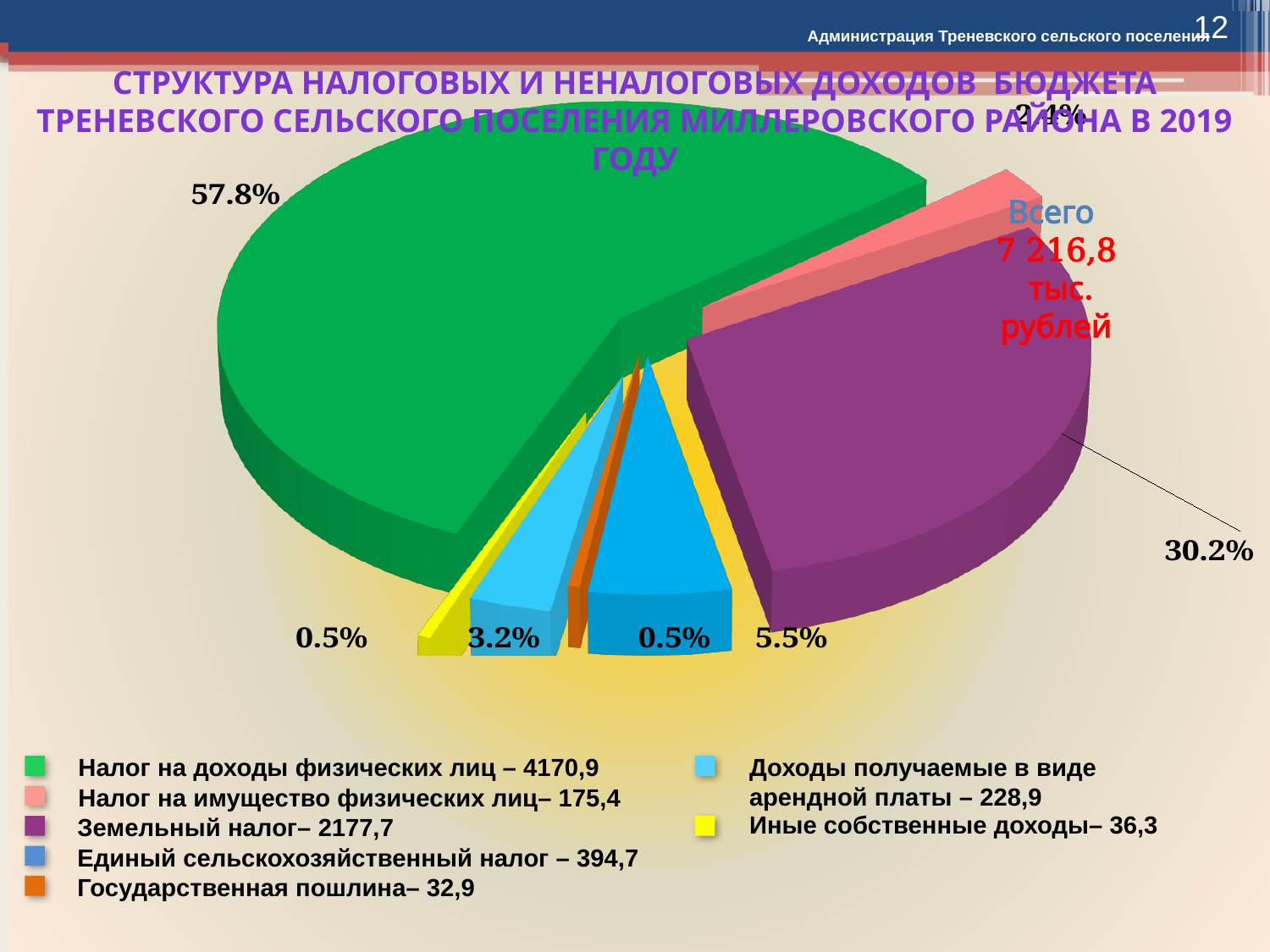
What value does the legend give for Земельный налог? 2177,7 What percentage share is shown for Доходы получаемые в виде арендной платы? 3.2% What value does the legend give for Государственная пошлина? 32,9 Which has the larger share: Земельный налог or Единый сельскохозяйственный налог? Земельный налог What total amount (Всего) is shown next to the pie chart? 7 216,8 тыс. рублей What is the difference in percentage points between the share of Налог на доходы физических лиц (57.8%) and Земельный налог (30.2%)? 27.6 Which category has the largest share of the pie? Налог на доходы физических лиц What colour is the slice for Налог на доходы физических лиц? green What percentage share does Единый сельскохозяйственный налог have? 5.5% How many categories does the legend list? 7 What kind of chart is shown on the slide? pie chart What percentage share does Земельный налог have in the pie chart? 30.2%